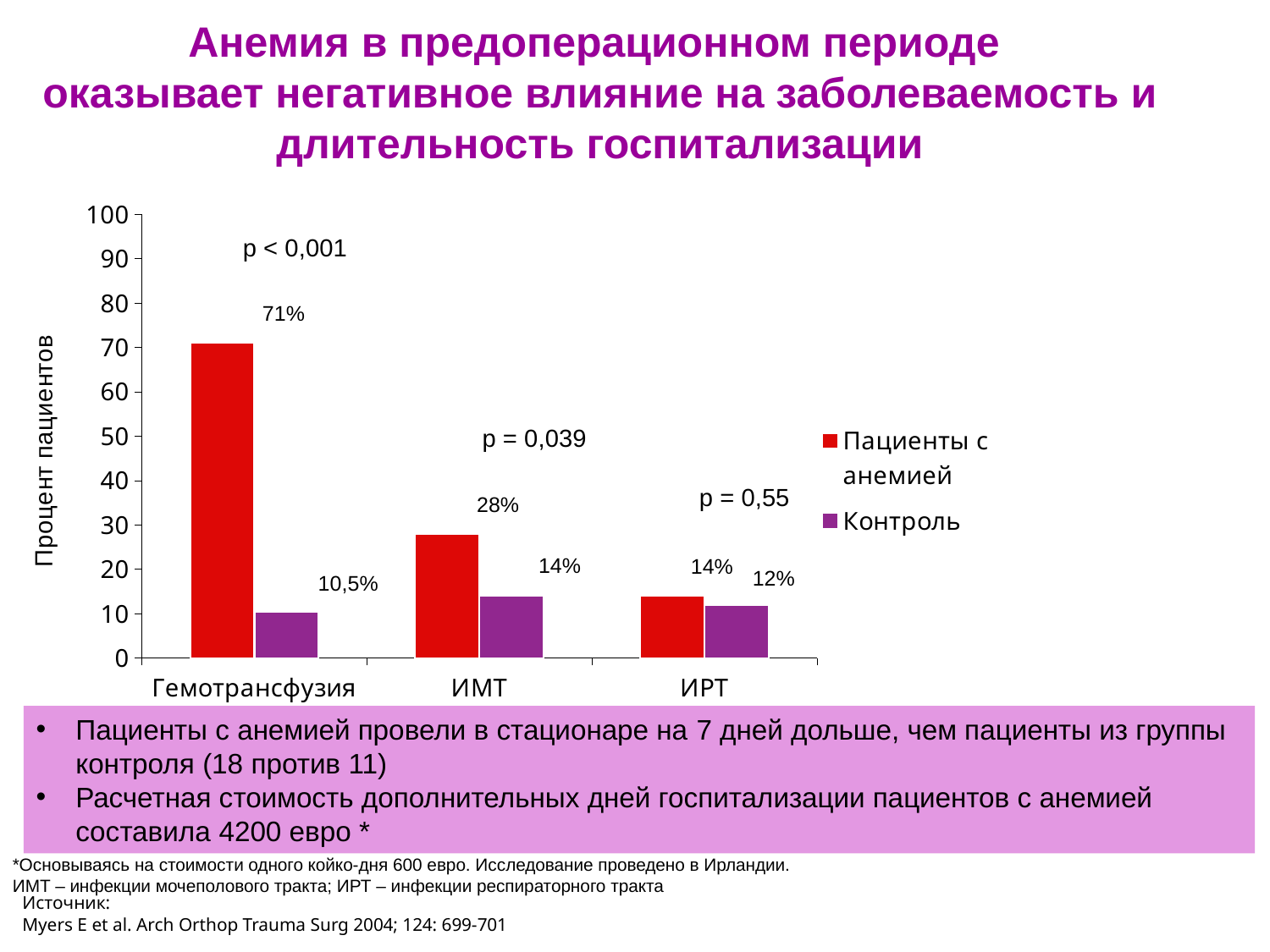
How many categories are shown on the x axis? 3 What is the value for Пациенты с анемией in the ИМТ category? 28% In which category is the value for Пациенты с анемией the highest? Гемотрансфузия How many series does the legend list? 2 What is the label of the y axis? Процент пациентов What is the value for Контроль in the ИРТ category? 12% What is the value for Пациенты с анемией in the Гемотрансфузия category? 71% What is the difference between the Пациенты с анемией and Контроль values in the ИМТ category? 14% What is the value for Контроль in the Гемотрансфузия category? 10,5% What kind of chart is shown on the slide? Bar chart Which is larger in the ИРТ category: Пациенты с анемией or Контроль? Пациенты с анемией In which category is the value for Контроль the lowest? Гемотрансфузия